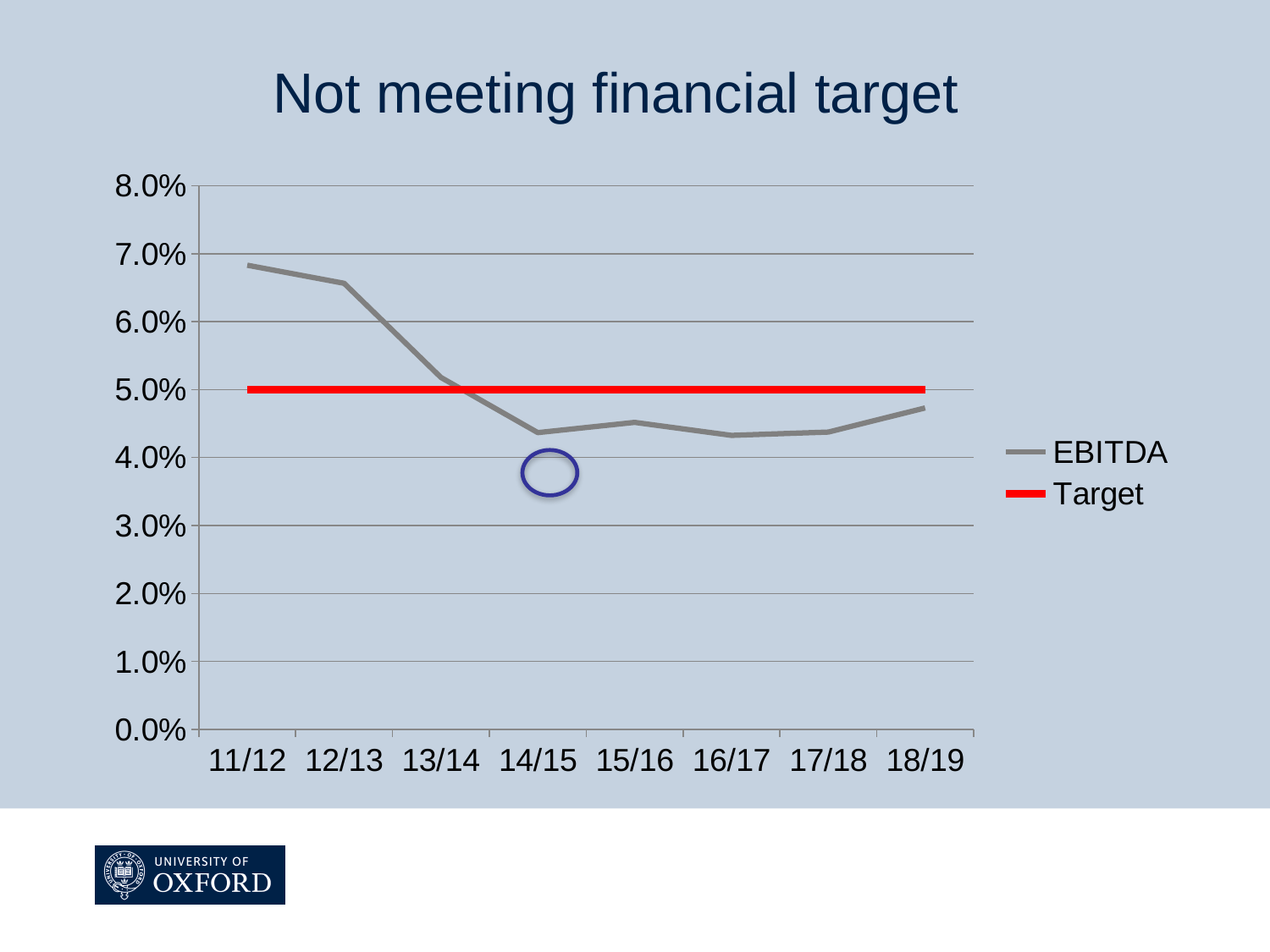
Is the EBITDA value for 18/19 greater or less than 5.0%? less What is the title of the slide? Not meeting financial target Is the EBITDA value for 11/12 greater or less than 6.0%? greater How many series does the legend list? 2 Which is larger, EBITDA in 12/13 or EBITDA in 14/15? 12/13 Is the EBITDA value for 14/15 greater or less than 5.0%? less How many years are shown on the x axis? 8 What colour is the Target line? red What is the value of the Target line? 5.0% In which year is EBITDA highest? 11/12 Does EBITDA rise or fall overall from 11/12 to 18/19? fall What kind of chart is shown on the slide? line chart